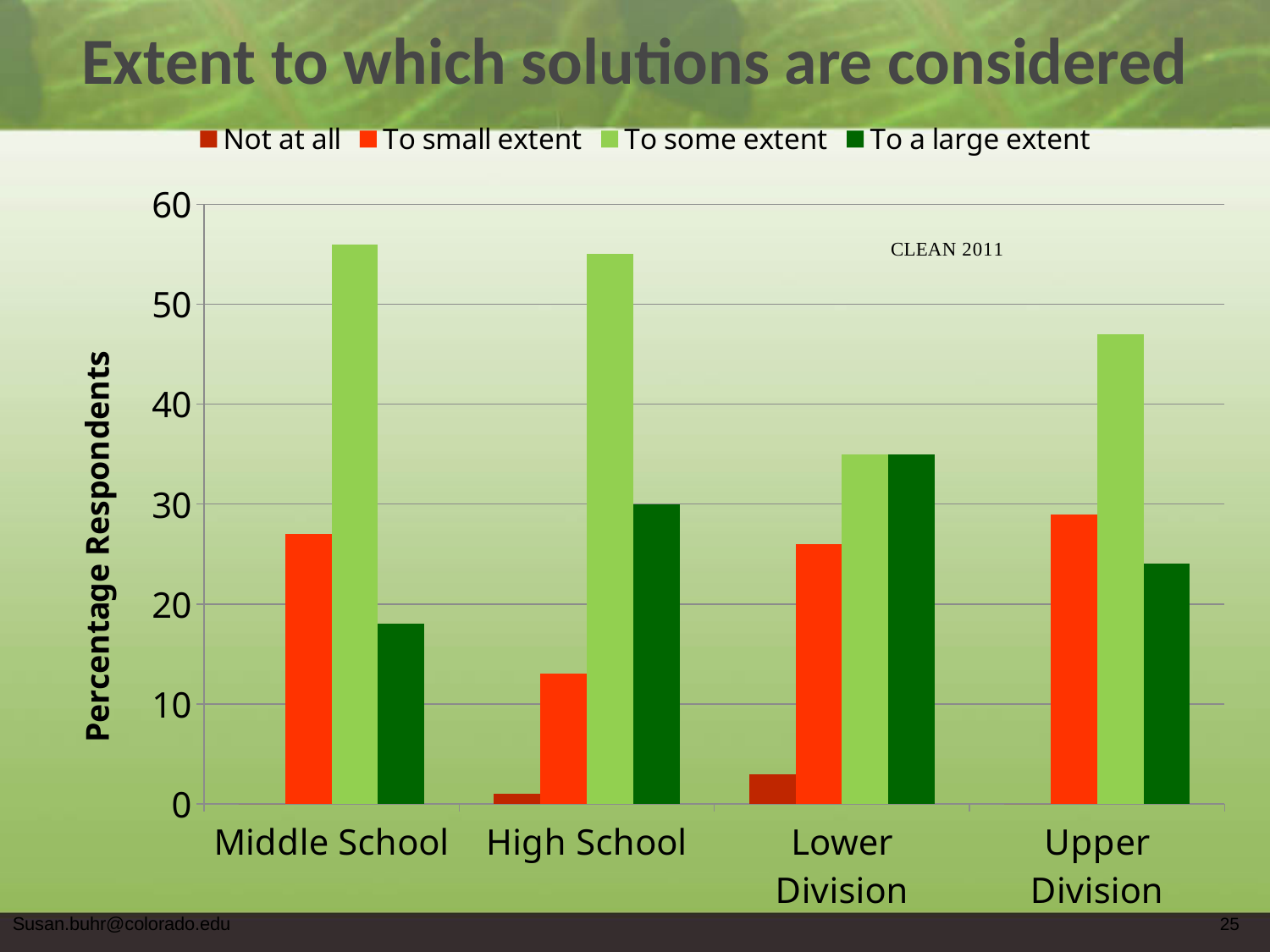
Is the value for To some extent in Upper Division greater or less than 50? less What is the label on the y axis? Percentage Respondents Is the value for To small extent in High School greater or less than 20? less For Middle School, which is larger: To small extent or To a large extent? To small extent Which series has the highest value for Middle School? To some extent Is the value for To some extent in Middle School greater or less than 50? greater Which series has the lowest value for High School? Not at all What is the title of the chart? Extent to which solutions are considered How many series does the legend list? 4 How many categories are shown on the x axis? 4 What kind of chart is shown on the slide? bar chart For Upper Division, which is larger: To some extent or To a large extent? To some extent